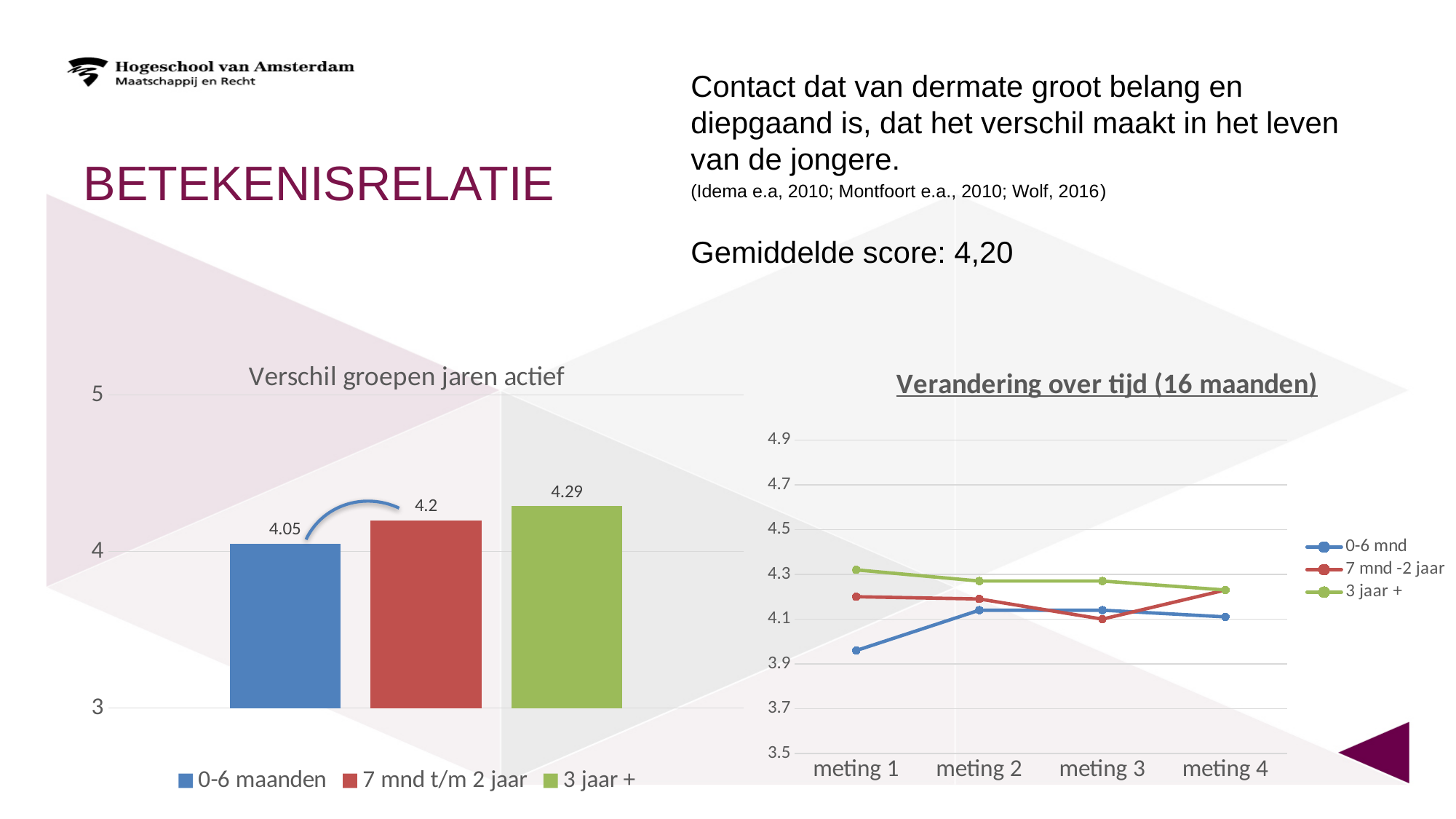
In the chart 'Verandering over tijd (16 maanden)', how many series does the legend list? 3 What kind of chart is 'Verschil groepen jaren actief'? bar chart In the chart 'Verschil groepen jaren actief', which group has the highest value? 3 jaar + In the chart 'Verschil groepen jaren actief', how many bars are shown? 3 In the chart 'Verschil groepen jaren actief', what is the difference between the values for '3 jaar +' and '0-6 maanden'? 0.24 In the chart 'Verschil groepen jaren actief', what is the value for '3 jaar +'? 4.29 In the chart 'Verandering over tijd (16 maanden)', how many measurement points are on the x axis? 4 In the chart 'Verandering over tijd (16 maanden)', is the value for '0-6 mnd' at meting 1 greater or less than 4.1? less In the chart 'Verschil groepen jaren actief', which group has the lowest value? 0-6 maanden In the chart 'Verschil groepen jaren actief', what is the value for '0-6 maanden'? 4.05 What kind of chart is 'Verandering over tijd (16 maanden)'? line chart In the chart 'Verandering over tijd (16 maanden)', which series has the highest value at meting 1? 3 jaar +